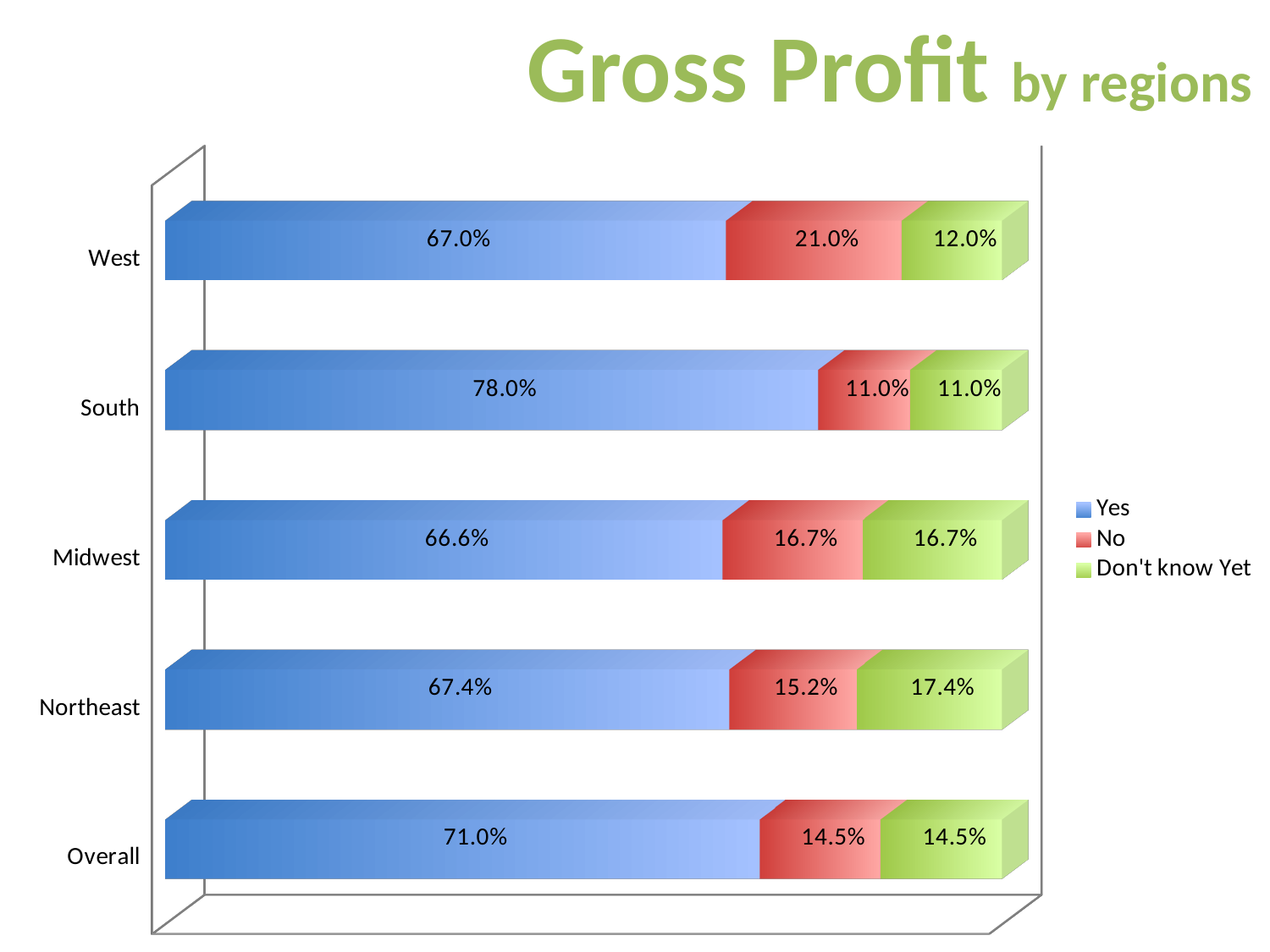
Which region has the highest "Yes" value? South Which region has the lowest "Yes" value? Midwest What is the "Yes" value for Overall? 71.0% What kind of chart is shown on the slide? Stacked bar chart What is the difference between the "Yes" values for South and West? 11.0% Which region has the highest "No" value? West How many series does the legend list? 3 What is the "Don't know Yet" value for the Northeast region? 17.4% What is the "No" value for the West region? 21.0% Which is larger, the "No" value for Midwest or the "No" value for Northeast? Midwest What is the "Yes" value for the South region? 78.0% How many categories (bars) are shown on the chart? 5